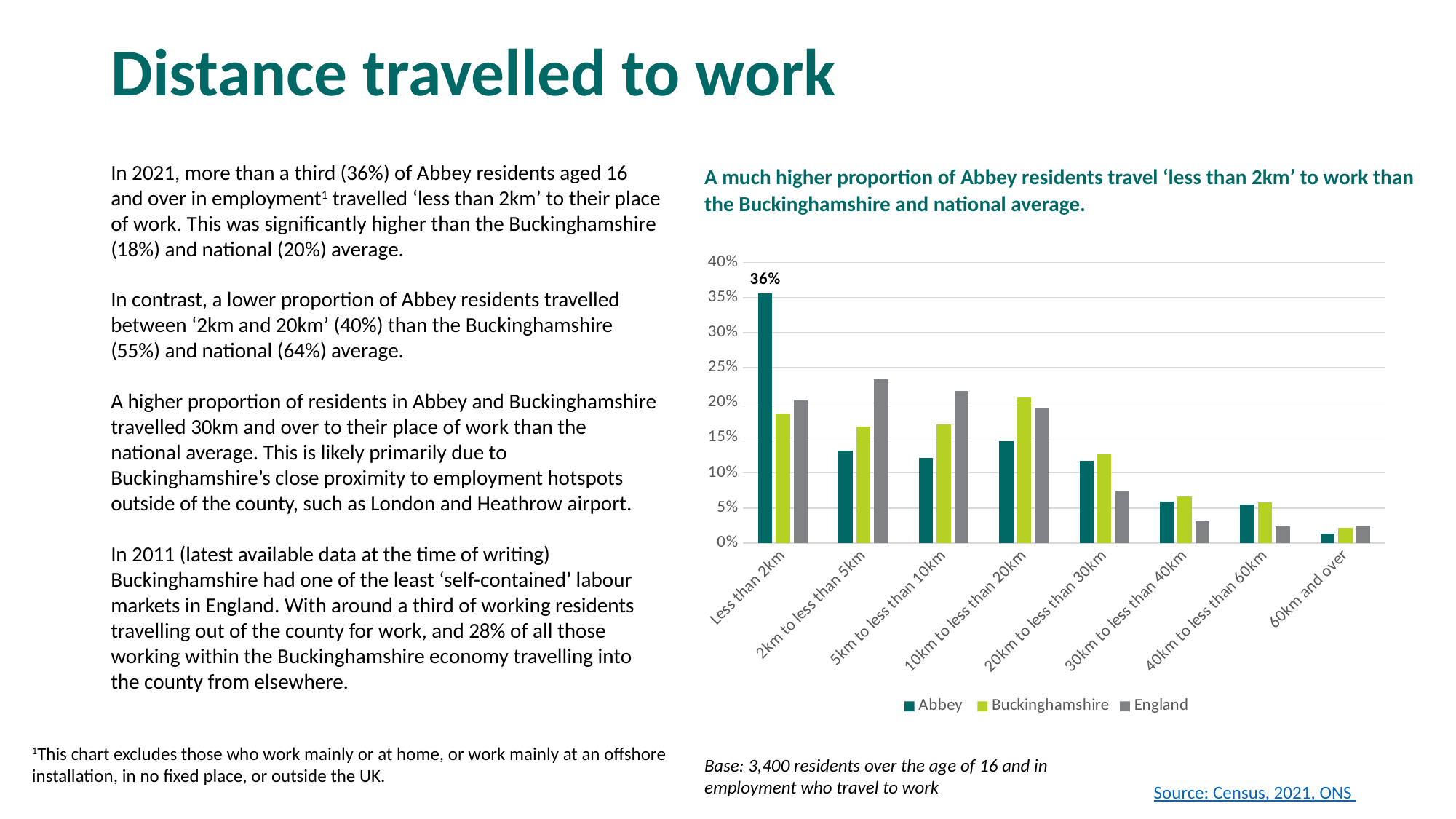
How many distance categories are shown on the x axis of the chart? 8 How many series does the chart's legend list? 3 What percentage of Abbey residents travel 'Less than 2km' to work? 36% What are the three series named in the chart's legend? Abbey, Buckinghamshire, England Is the Abbey value for '60km and over' greater or less than 5%? less What kind of chart is shown on the slide? Bar chart Which distance category has the highest value for Abbey? Less than 2km Which distance category has the lowest value for Abbey? 60km and over For 'Less than 2km', which is larger: the Abbey value or the England value? Abbey Is the England value for '2km to less than 5km' greater or less than 20%? greater Do the England values rise or fall from '10km to less than 20km' to '60km and over'? fall For '2km to less than 5km', which is larger: the Abbey value or the England value? England